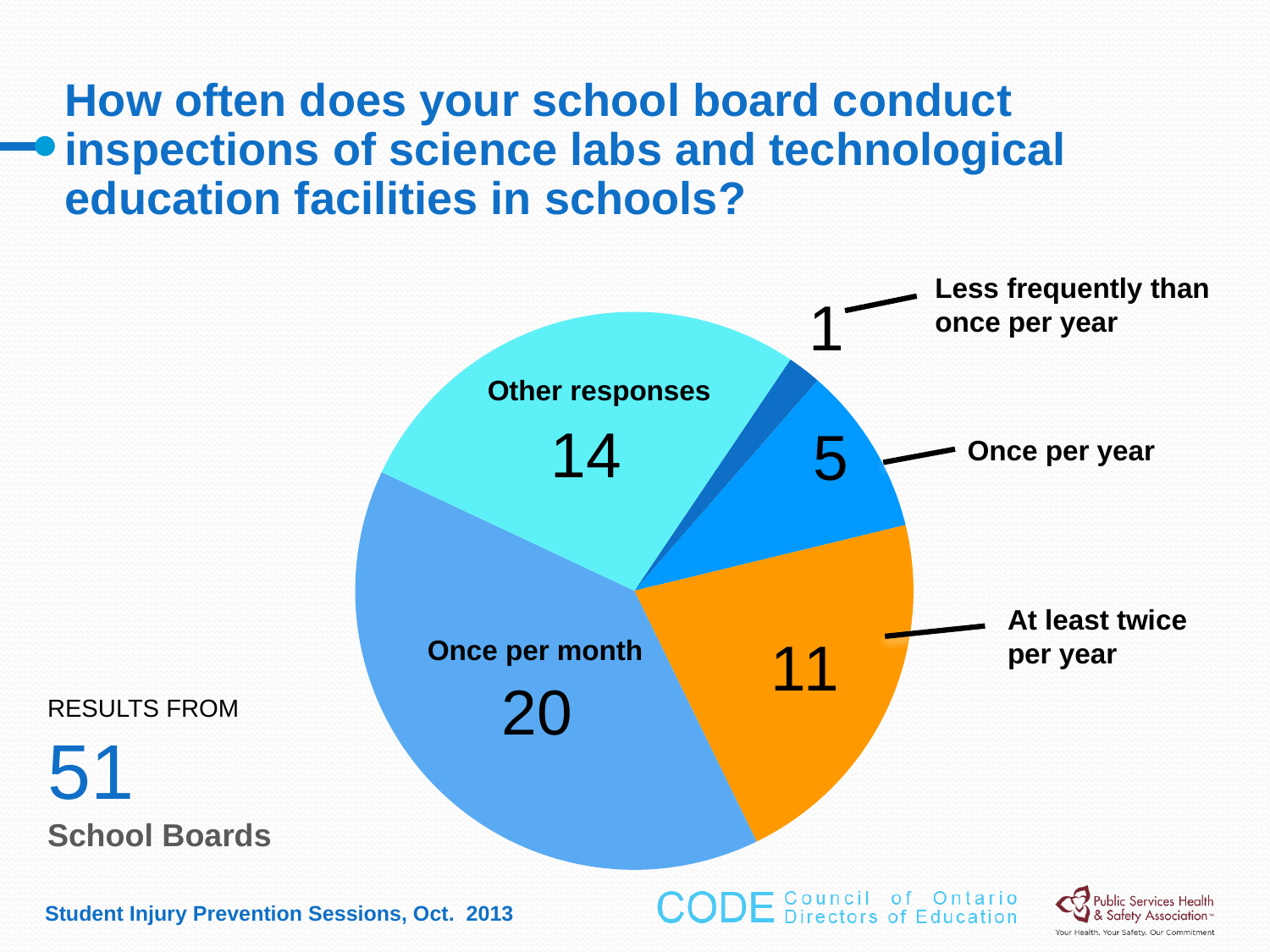
Which response category has the smallest slice? Less frequently than once per year How many school boards responded 'Once per month'? 20 What type of chart is shown on the slide? pie chart Which is larger, 'At least twice per year' or 'Once per year'? At least twice per year What is the difference between 'Once per month' and 'Other responses'? 6 What is the value for 'Other responses'? 14 What is the value for 'At least twice per year'? 11 What is the value for 'Once per year'? 5 Which response category has the largest slice? Once per month How many slices does the pie chart have? 5 What is the value for 'Less frequently than once per year'? 1 What is the total of all slices in the pie chart? 51